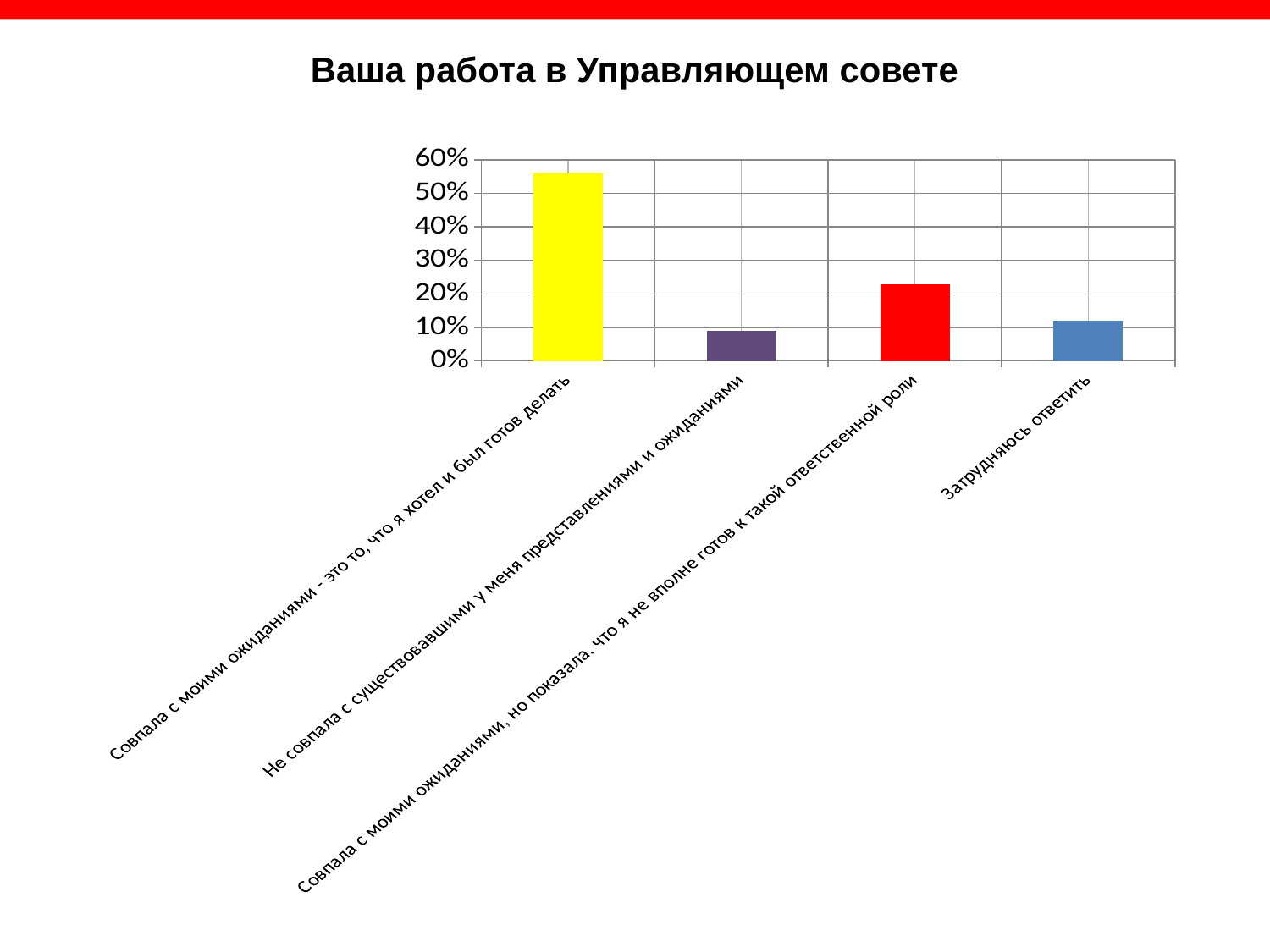
Is the value for "Не совпала с существовавшими у меня представлениями и ожиданиями" greater or less than 20%? less What type of chart is shown on the slide? bar chart Which category has the lowest value? Не совпала с существовавшими у меня представлениями и ожиданиями Which category has the highest value? Совпала с моими ожиданиями - это то, что я хотел и был готов делать How many categories are shown in the chart? 4 Is the value for "Совпала с моими ожиданиями - это то, что я хотел и был готов делать" greater or less than 50%? greater What colour is the bar for "Совпала с моими ожиданиями - это то, что я хотел и был готов делать"? yellow What is the title of the slide? Ваша работа в Управляющем совете Is the value for "Совпала с моими ожиданиями, но показала, что я не вполне готов к такой ответственной роли" greater or less than 20%? greater What is the maximum value shown on the vertical axis? 60% Which is larger: the value for "Совпала с моими ожиданиями, но показала, что я не вполне готов к такой ответственной роли" or the value for "Затрудняюсь ответить"? Совпала с моими ожиданиями, но показала, что я не вполне готов к такой ответственной роли